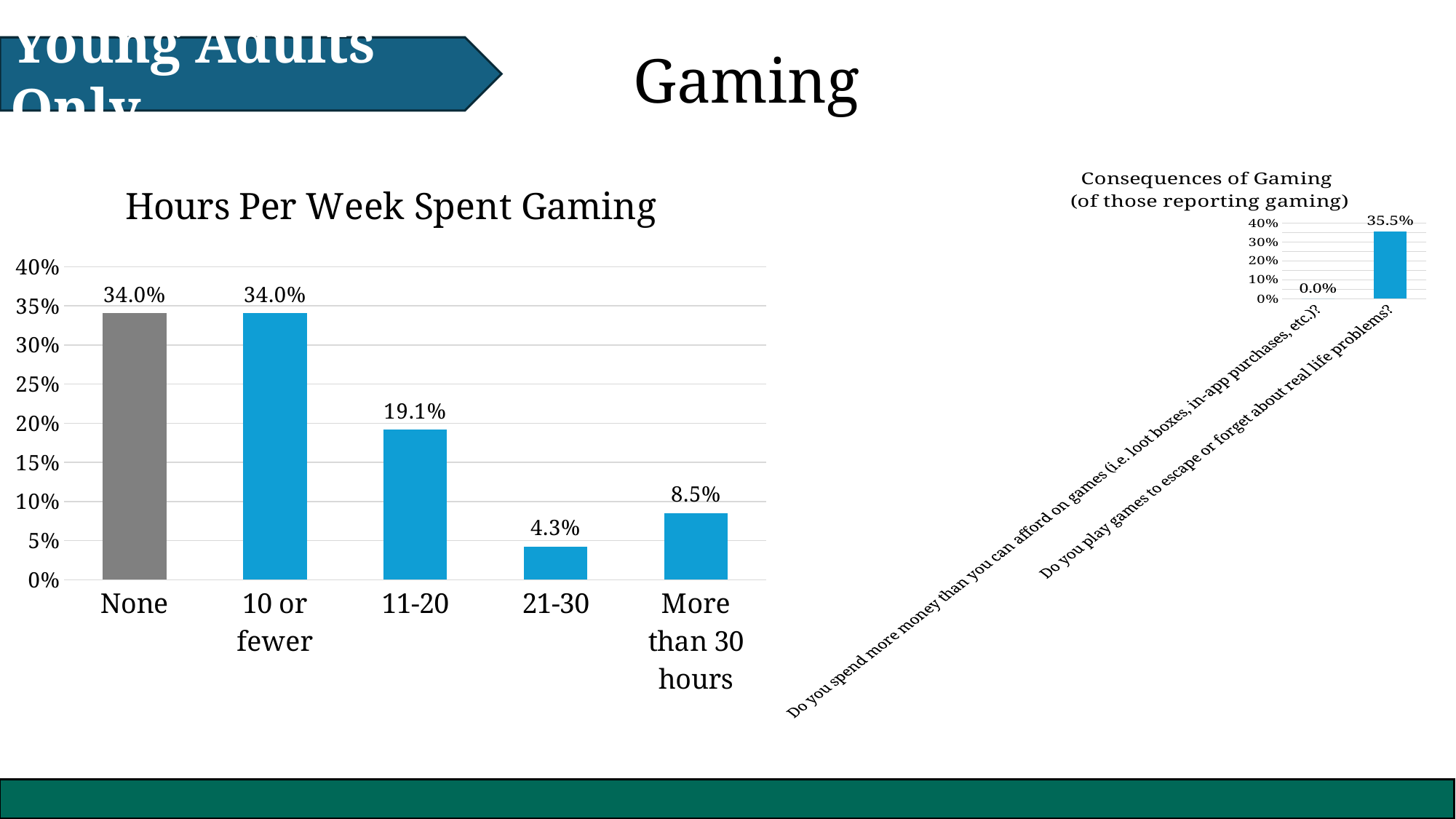
In the 'Hours Per Week Spent Gaming' chart, what is the value for 21-30? 4.3% In the 'Hours Per Week Spent Gaming' chart, which is larger, the value for 11-20 or the value for 'More than 30 hours'? 11-20 What kind of chart is 'Hours Per Week Spent Gaming'? Bar chart In the 'Consequences of Gaming' chart, what is the value for 'Do you play games to escape or forget about real life problems?'? 35.5% In the 'Hours Per Week Spent Gaming' chart, what is the value for 'More than 30 hours'? 8.5% In the 'Hours Per Week Spent Gaming' chart, what is the value for 11-20? 19.1% In the 'Consequences of Gaming' chart, what is the value for 'Do you spend more money than you can afford on games (i.e. loot boxes, in-app purchases, etc.)?'? 0.0% How many categories are shown in the 'Hours Per Week Spent Gaming' chart? 5 In the 'Hours Per Week Spent Gaming' chart, which category has the lowest value? 21-30 In the 'Hours Per Week Spent Gaming' chart, what is the difference between the values for 11-20 and 21-30? 14.8% In the 'Hours Per Week Spent Gaming' chart, which bar is coloured grey rather than blue? None How many categories are shown in the 'Consequences of Gaming' chart? 2